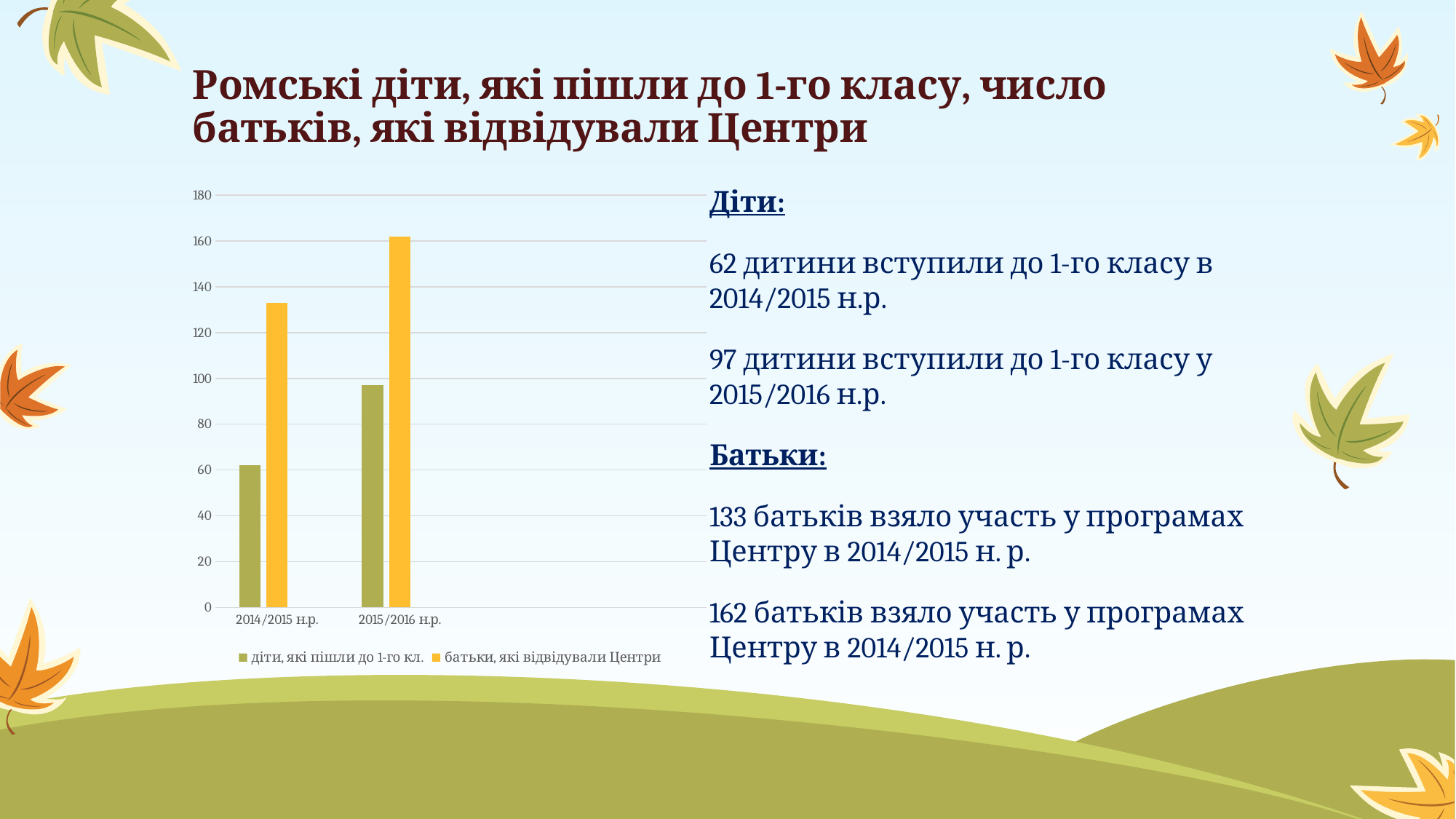
What is the value for 'діти, які пішли до 1-го кл.' in 2015/2016 н.р.? 97 What is the value for 'діти, які пішли до 1-го кл.' in 2014/2015 н.р.? 62 What kind of chart is shown on the slide? bar chart Is the value for 'батьки, які відвідували Центри' in 2015/2016 н.р. greater or less than 160? greater Which is larger in 2014/2015 н.р.: 'діти, які пішли до 1-го кл.' or 'батьки, які відвідували Центри'? батьки, які відвідували Центри Is the value for 'діти, які пішли до 1-го кл.' in 2015/2016 н.р. greater or less than 100? less Do the values for 'батьки, які відвідували Центри' rise or fall from 2014/2015 н.р. to 2015/2016 н.р.? rise How many categories are shown on the x axis of the chart? 2 How many series does the chart legend list? 2 By how much did the value for 'діти, які пішли до 1-го кл.' increase from 2014/2015 н.р. to 2015/2016 н.р.? 35 Which colour represents 'батьки, які відвідували Центри' in the chart? yellow What is the value for 'батьки, які відвідували Центри' in 2014/2015 н.р.? 133